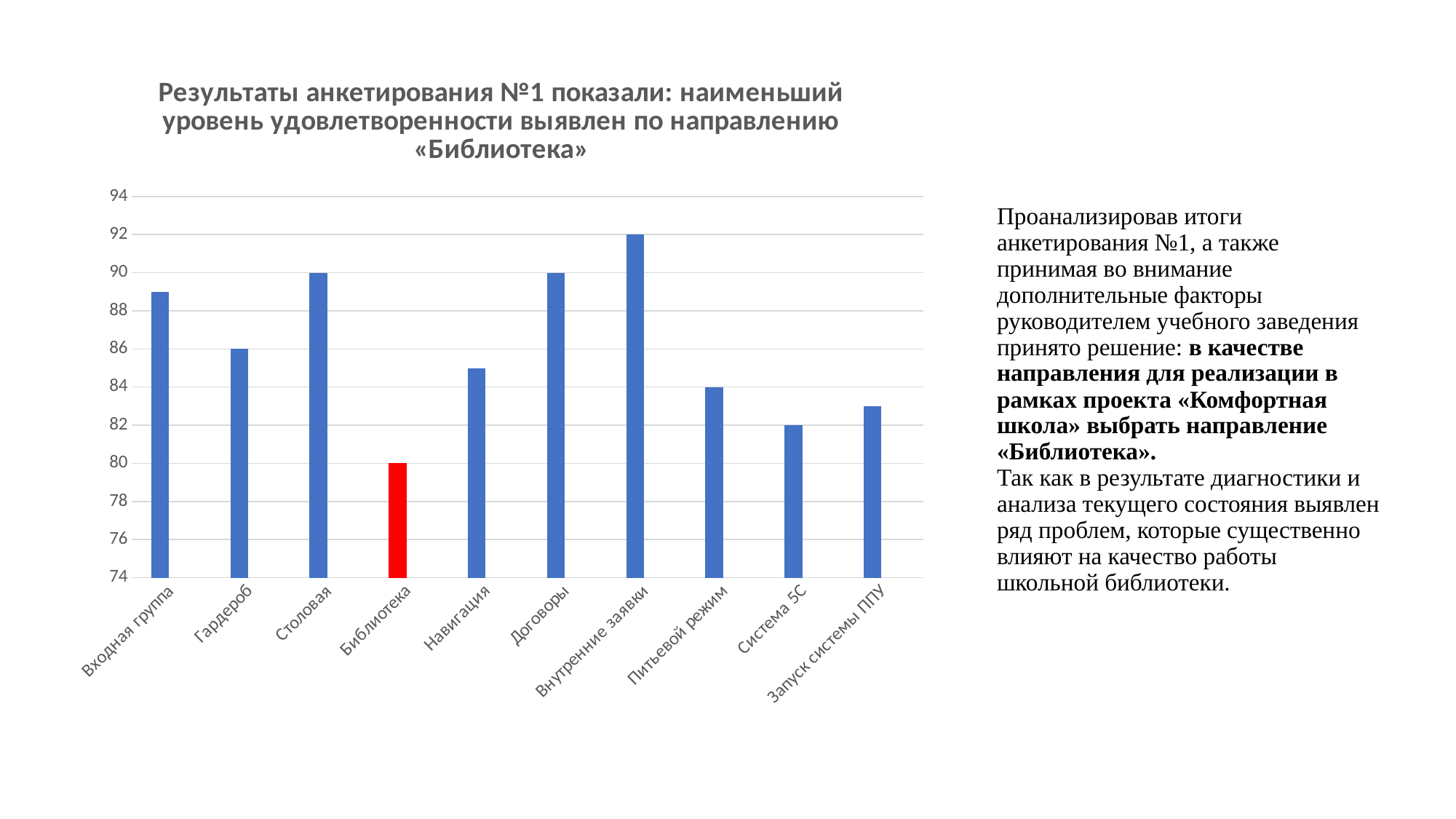
Which category has the lowest value? Библиотека What is the difference between the values for Внутренние заявки and Библиотека? 12 Is the value for Входная группа greater or less than 86? greater Which category has the highest value? Внутренние заявки How many categories are plotted on the chart? 10 Which is larger, the value for Столовая or the value for Питьевой режим? Столовая What is the value for Внутренние заявки? 92 What is the value for Библиотека? 80 What is the value for Гардероб? 86 What kind of chart is shown on the slide? bar chart What is the value for Система 5С? 82 Which category's bar is coloured red? Библиотека